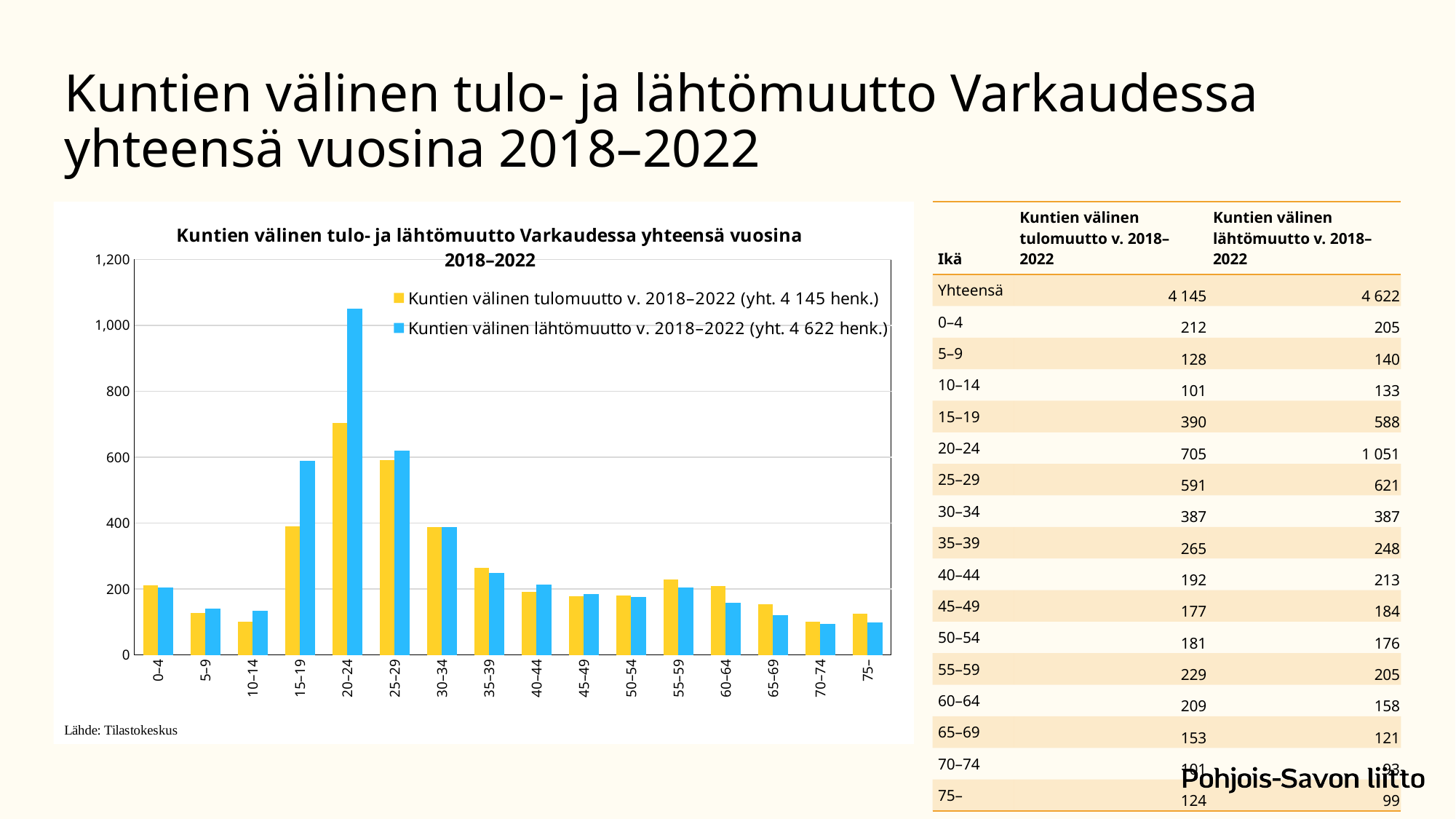
What kind of chart is shown on the slide? bar chart For the 15–19 age group, which is larger: tulomuutto or lähtömuutto? lähtömuutto Which age group has the highest value for Kuntien välinen tulomuutto v. 2018–2022? 20–24 How many age groups are shown on the x axis of the chart? 16 What is the value of Kuntien välinen tulomuutto v. 2018–2022 for the 20–24 age group? 705 Is the value for Kuntien välinen lähtömuutto in the 15–19 age group greater or less than 400? greater How many series does the chart's legend list? 2 Which age group has the highest value for Kuntien välinen lähtömuutto v. 2018–2022? 20–24 What is the value of Kuntien välinen lähtömuutto v. 2018–2022 for the 20–24 age group? 1 051 What is the difference between lähtömuutto and tulomuutto for the 20–24 age group? 346 Is the value for Kuntien välinen tulomuutto in the 10–14 age group greater or less than 200? less According to the legend, what is the total number of people for Kuntien välinen tulomuutto v. 2018–2022? 4 145 henk.